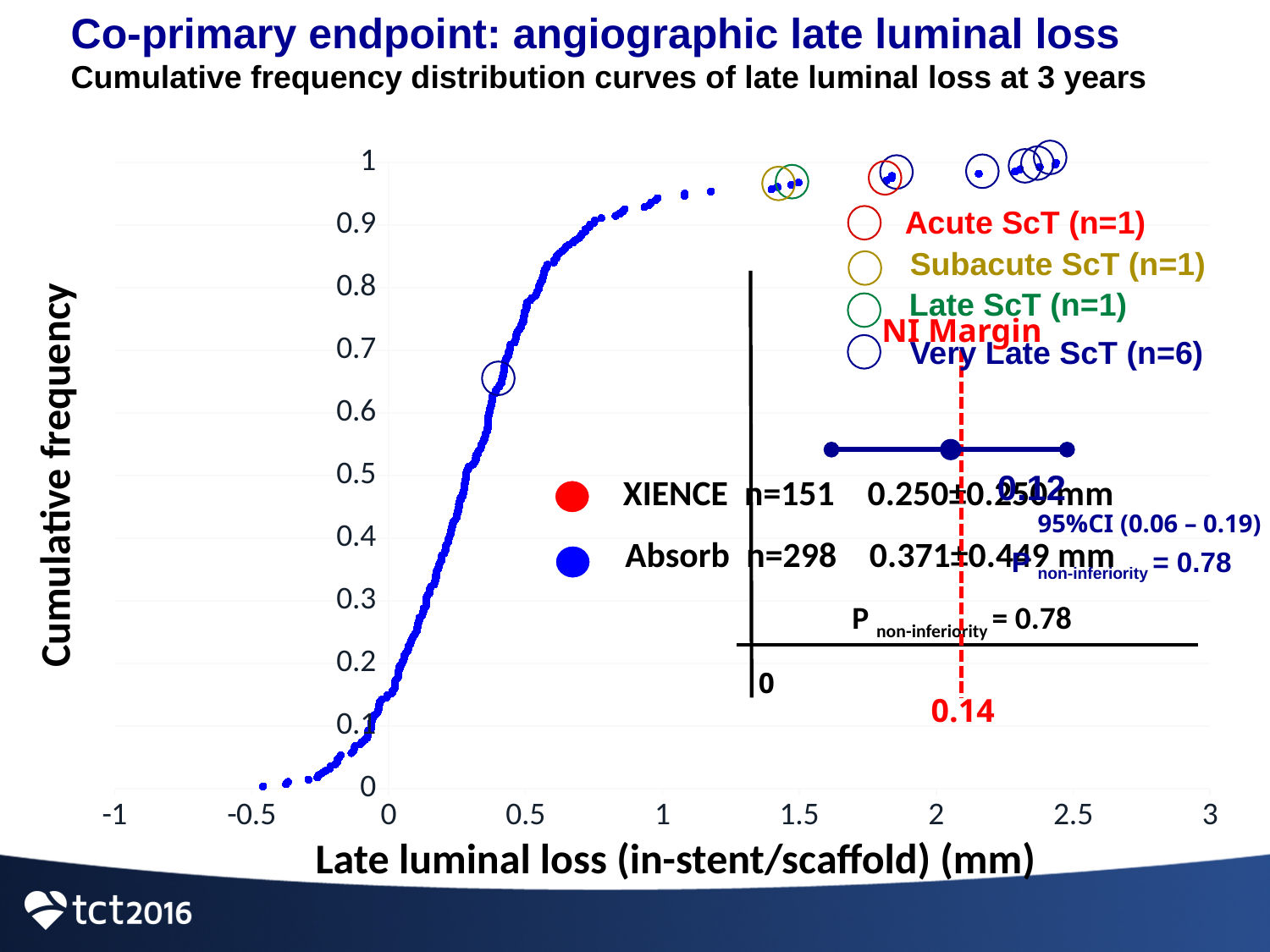
Does the cumulative frequency rise or fall as late luminal loss increases along the x axis? Rises What is the n for the Absorb group? 298 Which group has the larger n, Absorb or XIENCE? Absorb Which ScT category has the largest number of cases? Very Late ScT What is the NI margin value shown on the chart? 0.14 What is the 95% CI shown on the chart? (0.06 – 0.19) How many cases are in the Very Late ScT category? 6 How many scaffold thrombosis (ScT) categories are listed in the legend? 4 What is the n for the XIENCE group? 151 At a late luminal loss of 0 mm, is the cumulative frequency of the Absorb curve greater or less than 0.5? less What is the non-inferiority P value shown? 0.78 What kind of chart is shown on the slide? Scatter chart (cumulative frequency distribution curve)